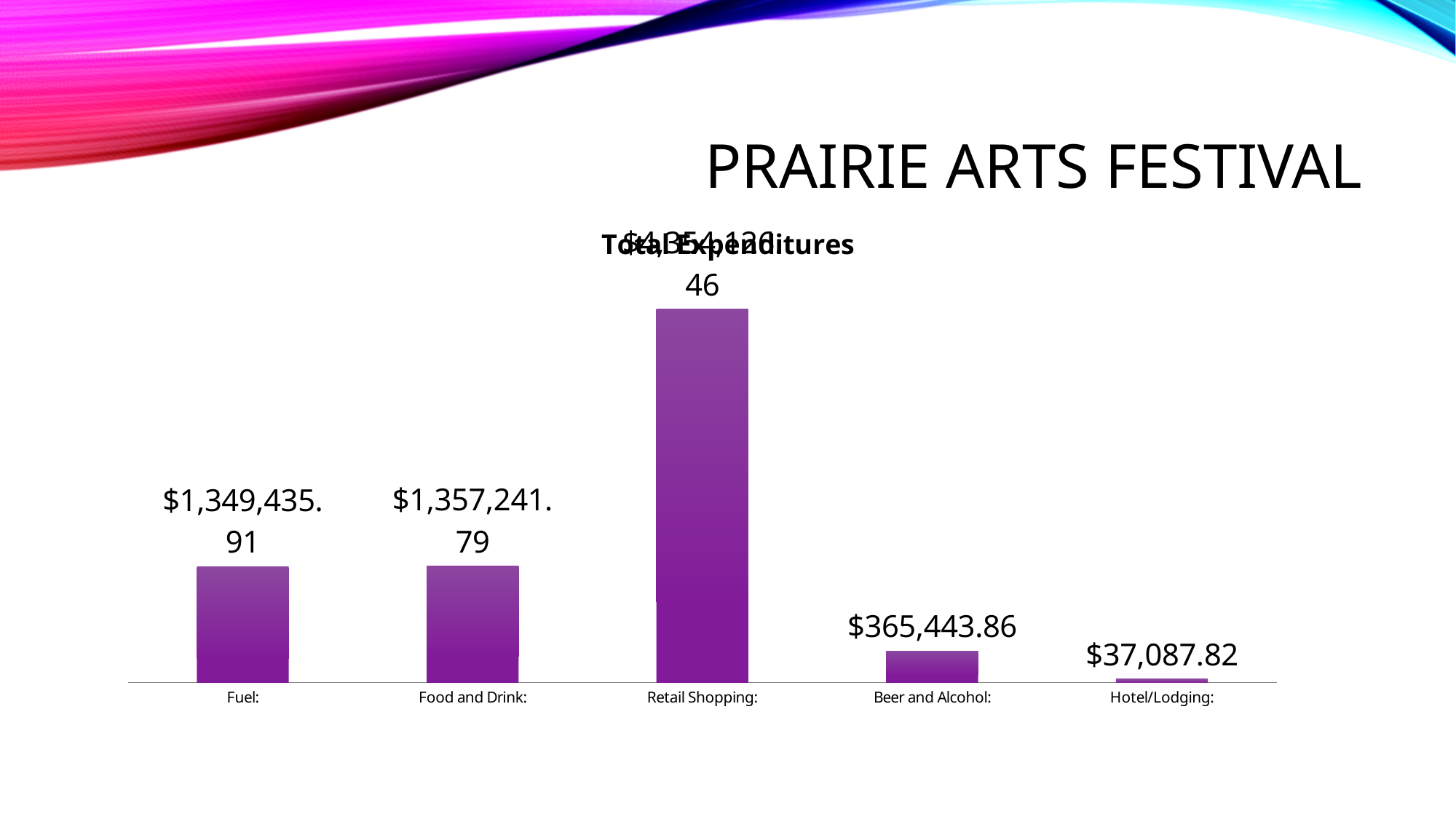
What is the difference between the values for Beer and Alcohol and Hotel/Lodging? $328,356.04 Which is larger, the value for Beer and Alcohol or the value for Hotel/Lodging? Beer and Alcohol What is the value for Food and Drink? $1,357,241.79 What is the value for Hotel/Lodging? $37,087.82 What is the value for Beer and Alcohol? $365,443.86 What is the difference between the values for Food and Drink and Fuel? $7,805.88 Which category has the lowest value? Hotel/Lodging What kind of chart is shown on the slide? Bar chart Which category has the highest value? Retail Shopping What is the value for Fuel? $1,349,435.91 How many categories are shown in the chart? 5 Which is larger, the value for Fuel or the value for Food and Drink? Food and Drink